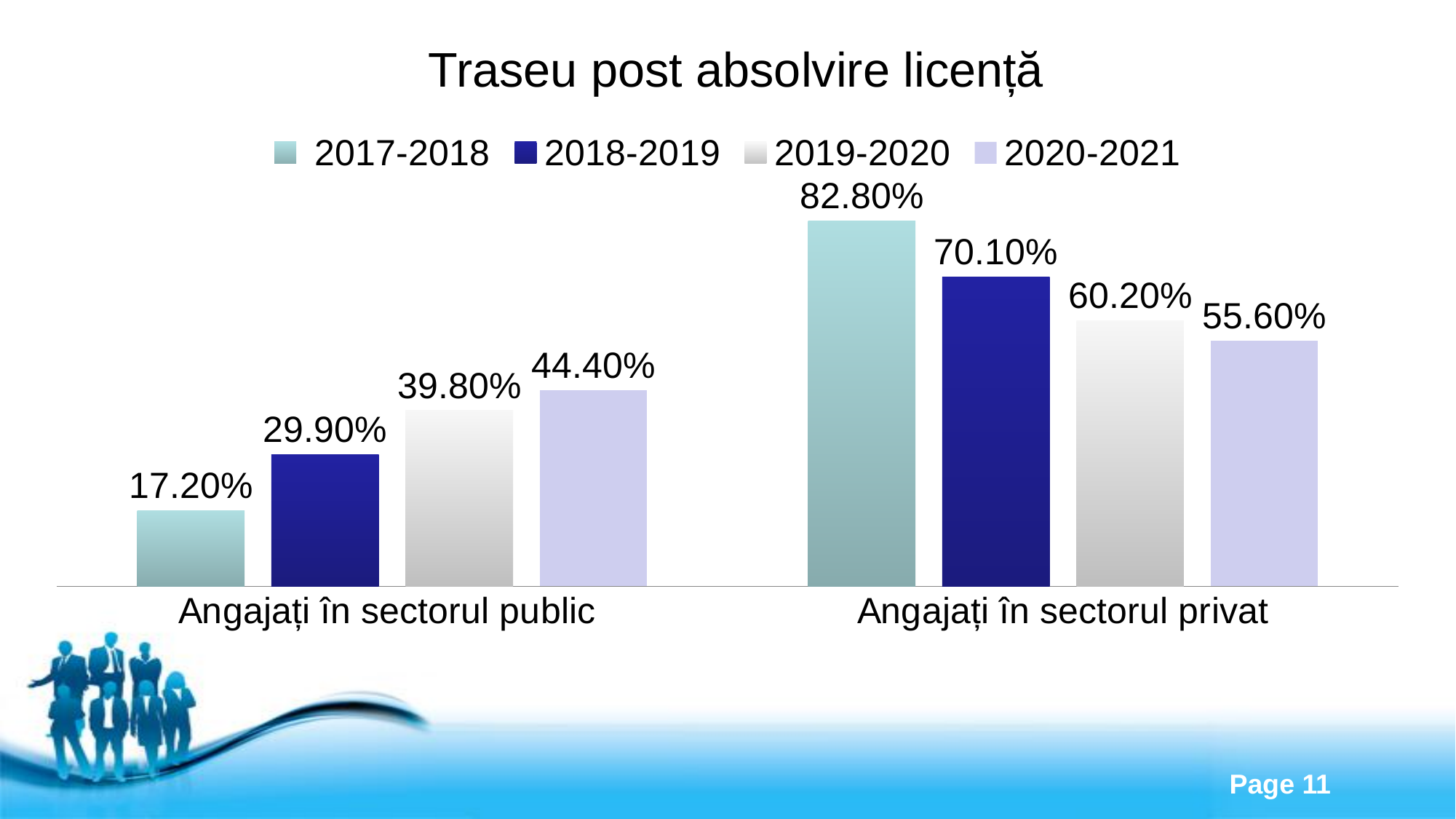
What is the value for 2019-2020 in the 'Angajați în sectorul public' category? 39.80% Do the values for 'Angajați în sectorul privat' rise or fall from 2017-2018 to 2020-2021? Fall What kind of chart is shown on the slide? Bar chart What is the title of the chart? Traseu post absolvire licență What is the value for 2020-2021 in the 'Angajați în sectorul privat' category? 55.60% Which is larger: the 2020-2021 value for 'Angajați în sectorul public' or the 2019-2020 value for 'Angajați în sectorul public'? 2020-2021 How many series does the legend list? 4 Which series has the highest value in the 'Angajați în sectorul privat' category? 2017-2018 What is the difference between the 2018-2019 values for 'Angajați în sectorul privat' and 'Angajați în sectorul public'? 40.20% Which series has the lowest value in the 'Angajați în sectorul public' category? 2017-2018 What is the value for 2017-2018 in the 'Angajați în sectorul public' category? 17.20% How many categories are shown on the x axis? 2